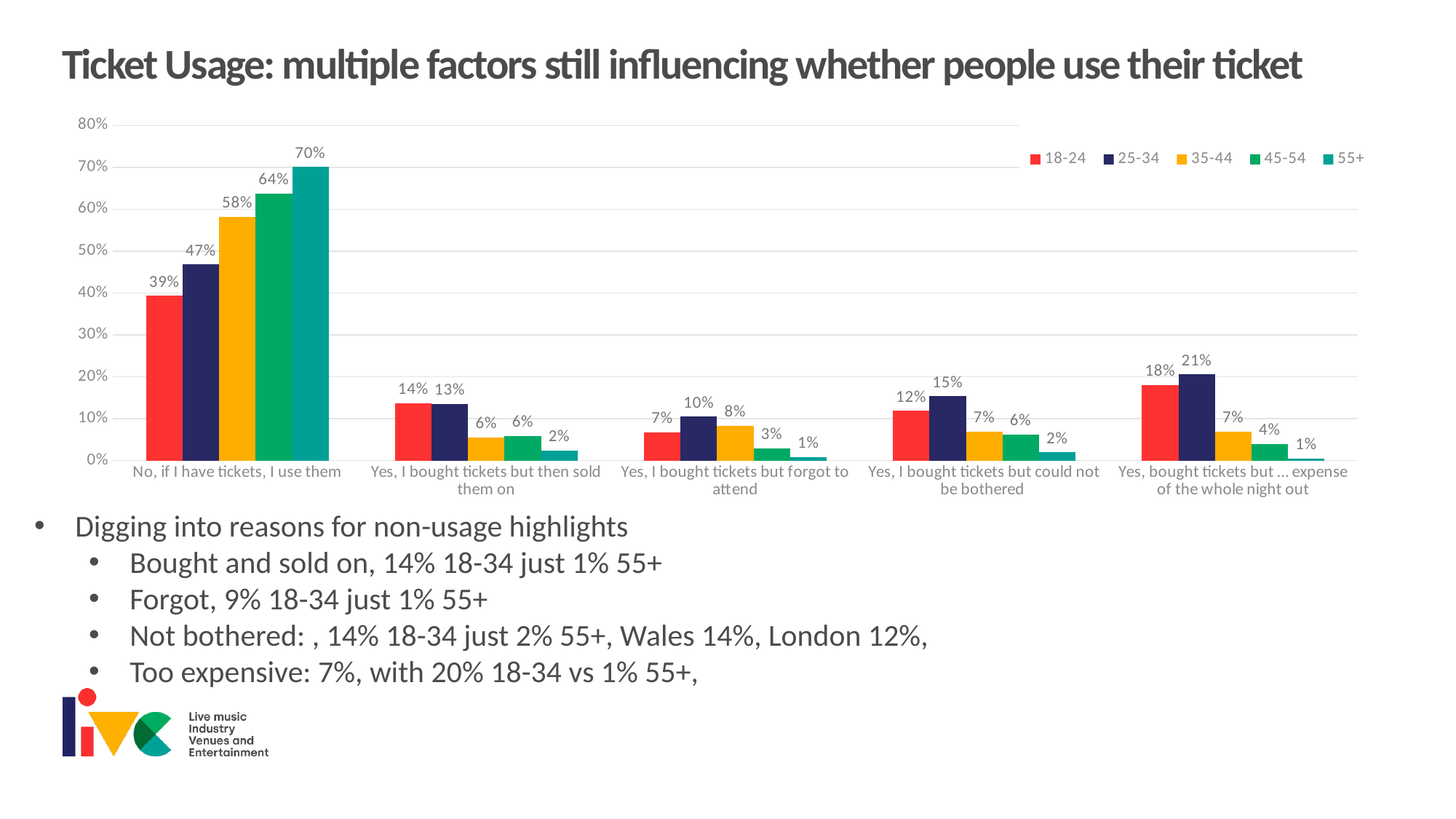
What is the value for the 55+ series in the category "No, if I have tickets, I use them"? 70% What is the value for the 25-34 series in the category "Yes, I bought tickets but forgot to attend"? 10% What is the value for the 18-24 series in the category "Yes, I bought tickets but then sold them on"? 14% What is the difference between the 55+ and 18-24 values in the category "No, if I have tickets, I use them"? 31% How many categories are shown on the x axis of the chart? 5 In the category "Yes, I bought tickets but could not be bothered", which is larger: the 18-24 value or the 25-34 value? 25-34 Which age group has the lowest value in the category "Yes, bought tickets but ... expense of the whole night out"? 55+ How many series does the chart's legend list? 5 What is the value for the 35-44 series in the category "Yes, I bought tickets but could not be bothered"? 7% Is the value for 45-54 in the category "No, if I have tickets, I use them" greater or less than 60%? greater Which age group has the highest value in the category "No, if I have tickets, I use them"? 55+ What kind of chart is shown on the slide? Bar chart